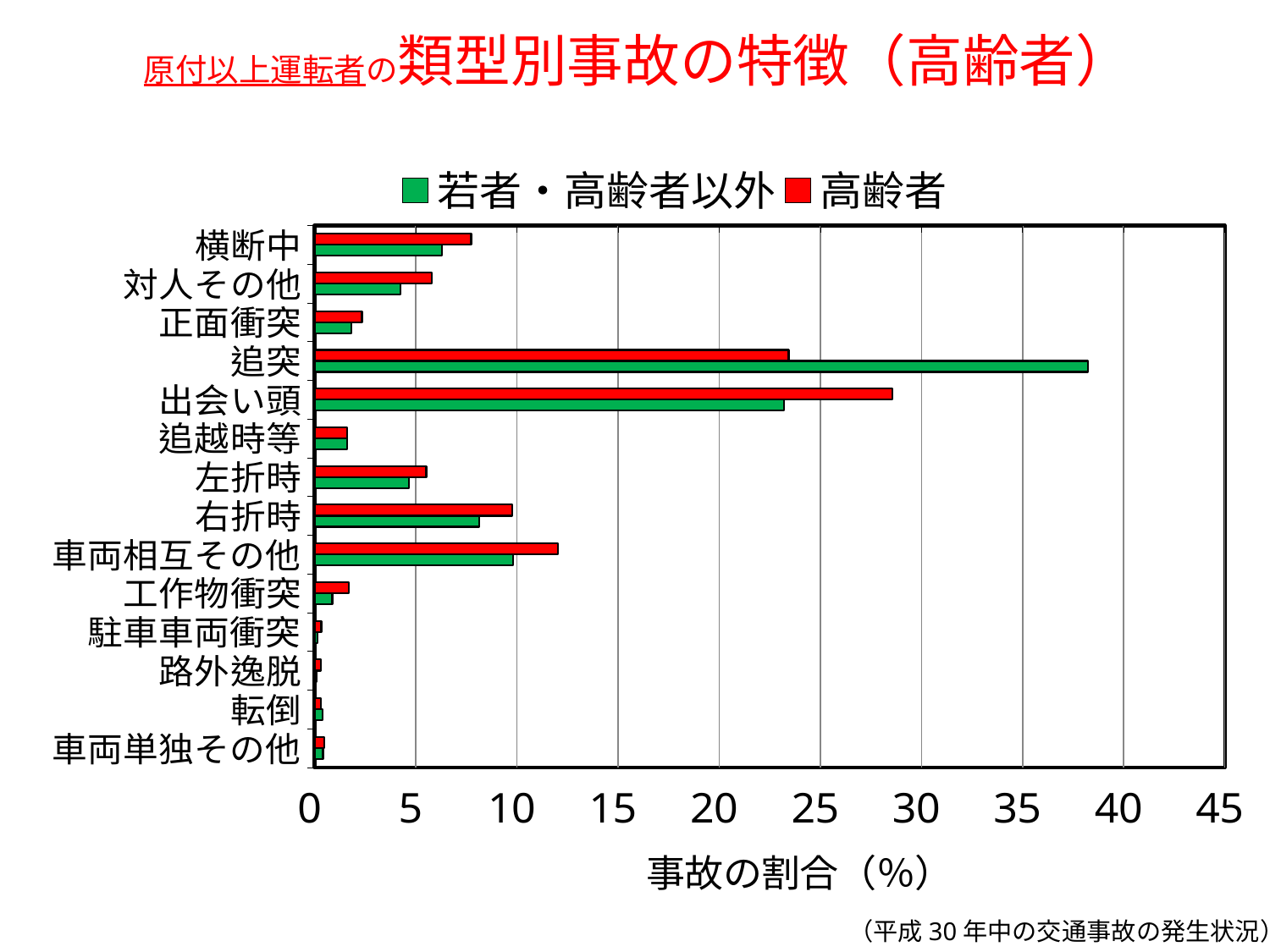
Is the 高齢者 value for 出会い頭 greater or less than 25? greater Is the 高齢者 value for 横断中 greater or less than 10? less For 追突, which series has the larger value, 若者・高齢者以外 or 高齢者? 若者・高齢者以外 How many series does the legend list? 2 Which category has the highest value for the 高齢者 series? 出会い頭 Which category has the highest value for the 若者・高齢者以外 series? 追突 What colour represents the 高齢者 series in the chart? red Is the 高齢者 value for 車両相互その他 greater or less than 10? greater What kind of chart is shown on the slide? bar chart How many accident-type categories are plotted on the chart? 14 For 出会い頭, which series has the larger value, 若者・高齢者以外 or 高齢者? 高齢者